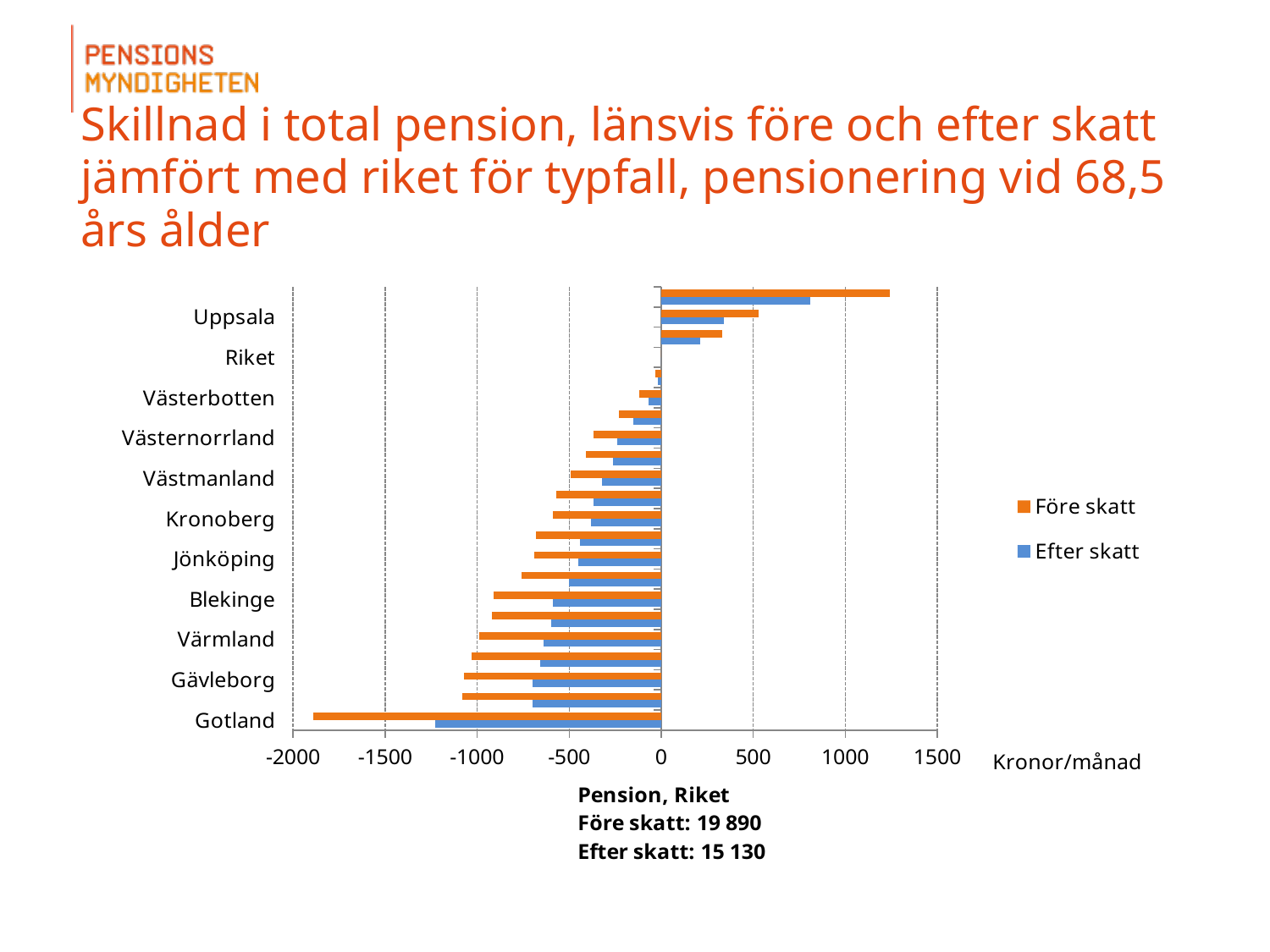
What kind of chart is shown on the slide? bar chart Which county has the lowest value for Före skatt? Gotland What is the lowest value shown on the horizontal axis? -2000 What is the pension for Riket after tax (Efter skatt) according to the note under the chart? 15 130 What is the pension for Riket before tax (Före skatt) according to the note under the chart? 19 890 Is the Efter skatt value for Gotland greater or less than -1000? less How many series does the legend list? 2 What are the two series named in the legend? Före skatt and Efter skatt Is the Före skatt value for Gotland greater or less than -1500? less For Gotland, which series has the longer bar, Före skatt or Efter skatt? Före skatt Is the Efter skatt value for Gotland greater or less than -1500? greater What unit is shown on the horizontal axis? Kronor/månad